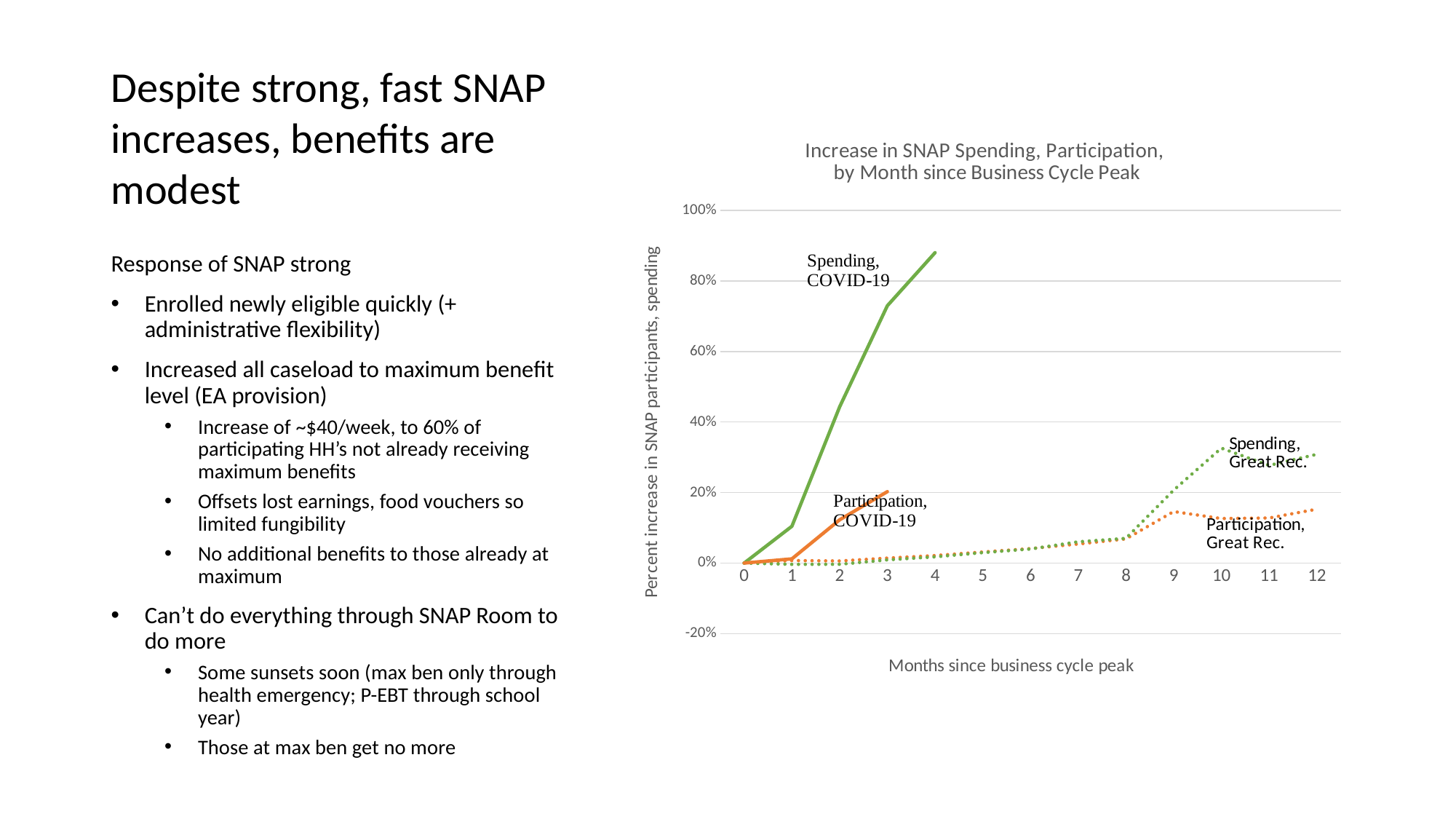
Does the Spending, COVID-19 series rise or fall from month 0 to month 4? Rise Is the value for Participation, Great Rec. at month 12 greater or less than 20%? less How many month values are marked on the x axis? 13 Is the value for Spending, COVID-19 at month 4 greater or less than 80%? greater Which series reaches the highest value on the chart? Spending, COVID-19 At month 3, which is larger: Spending, COVID-19 or Participation, COVID-19? Spending, COVID-19 What is the label of the x axis? Months since business cycle peak Is the value for Spending, COVID-19 at month 1 greater or less than 20%? less What is the title of the chart? Increase in SNAP Spending, Participation, by Month since Business Cycle Peak How many series are labelled on the chart? 4 What kind of chart is shown on the slide? Line chart